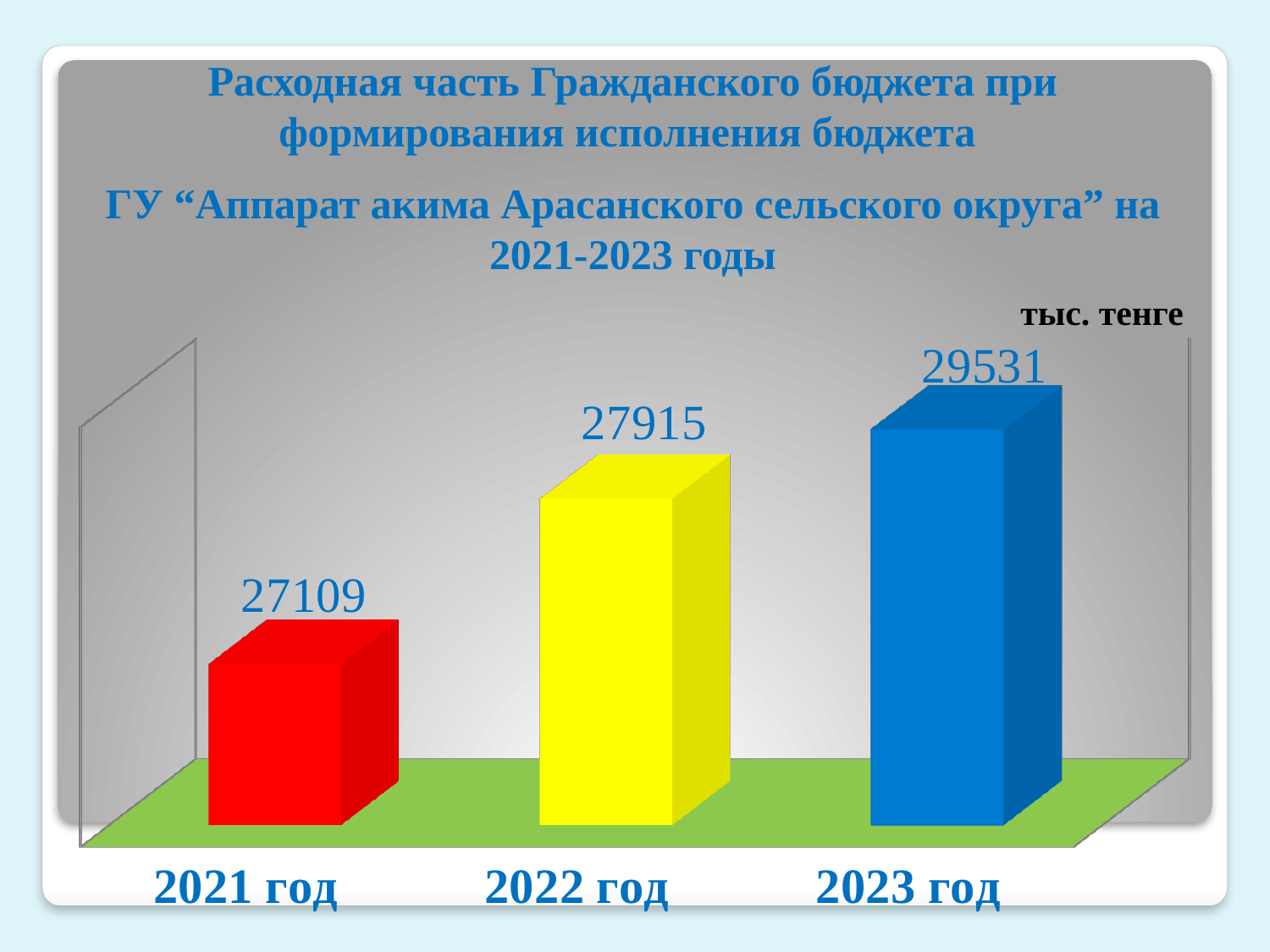
What is the difference between the values for 2023 год and 2021 год? 2422 Which year has the lowest value? 2021 год Do the values rise or fall from 2021 год to 2023 год? Rise What is the value for 2023 год? 29531 What is the value for 2021 год? 27109 How many bars are shown in the chart? 3 Which is larger, the value for 2022 год or the value for 2023 год? 2023 год What is the value for 2022 год? 27915 What kind of chart is shown on the slide? Bar chart In what units are the chart values given? тыс. тенге What is the difference between the values for 2022 год and 2021 год? 806 Which year has the highest value? 2023 год